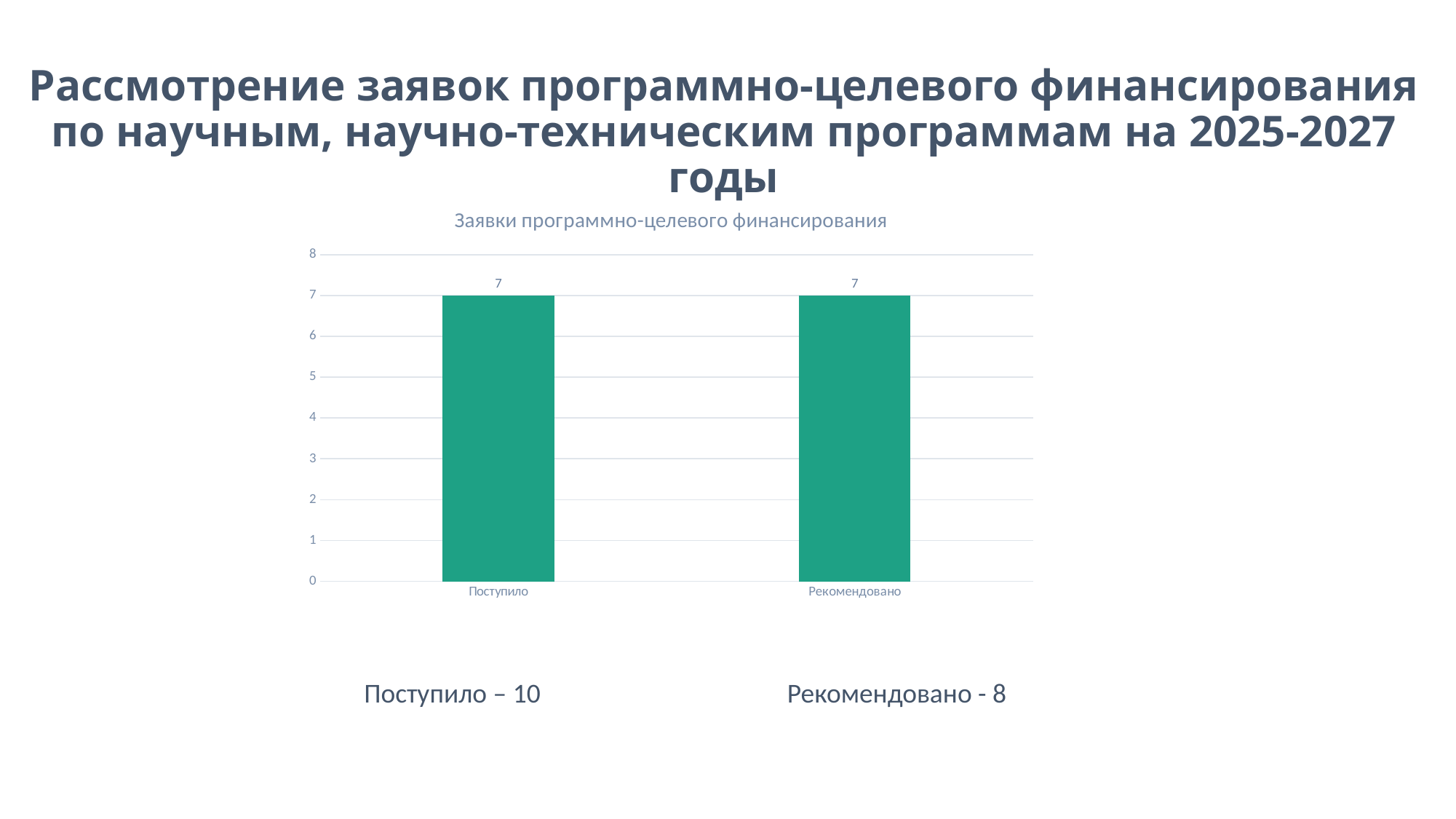
What is the highest value shown on the vertical axis of the chart? 8 What is the value of the bar for Поступило? 7 What is the title of the chart? Заявки программно-целевого финансирования What kind of chart is shown on the slide? bar chart Is the value for Поступило greater or less than 5? greater How many categories are shown on the x axis of the chart? 2 Is the value for Рекомендовано greater or less than 8? less What is the value of the bar for Рекомендовано? 7 What is the difference between the values for Поступило and Рекомендовано? 0 Do the values rise, fall or stay the same from Поступило to Рекомендовано? stay the same